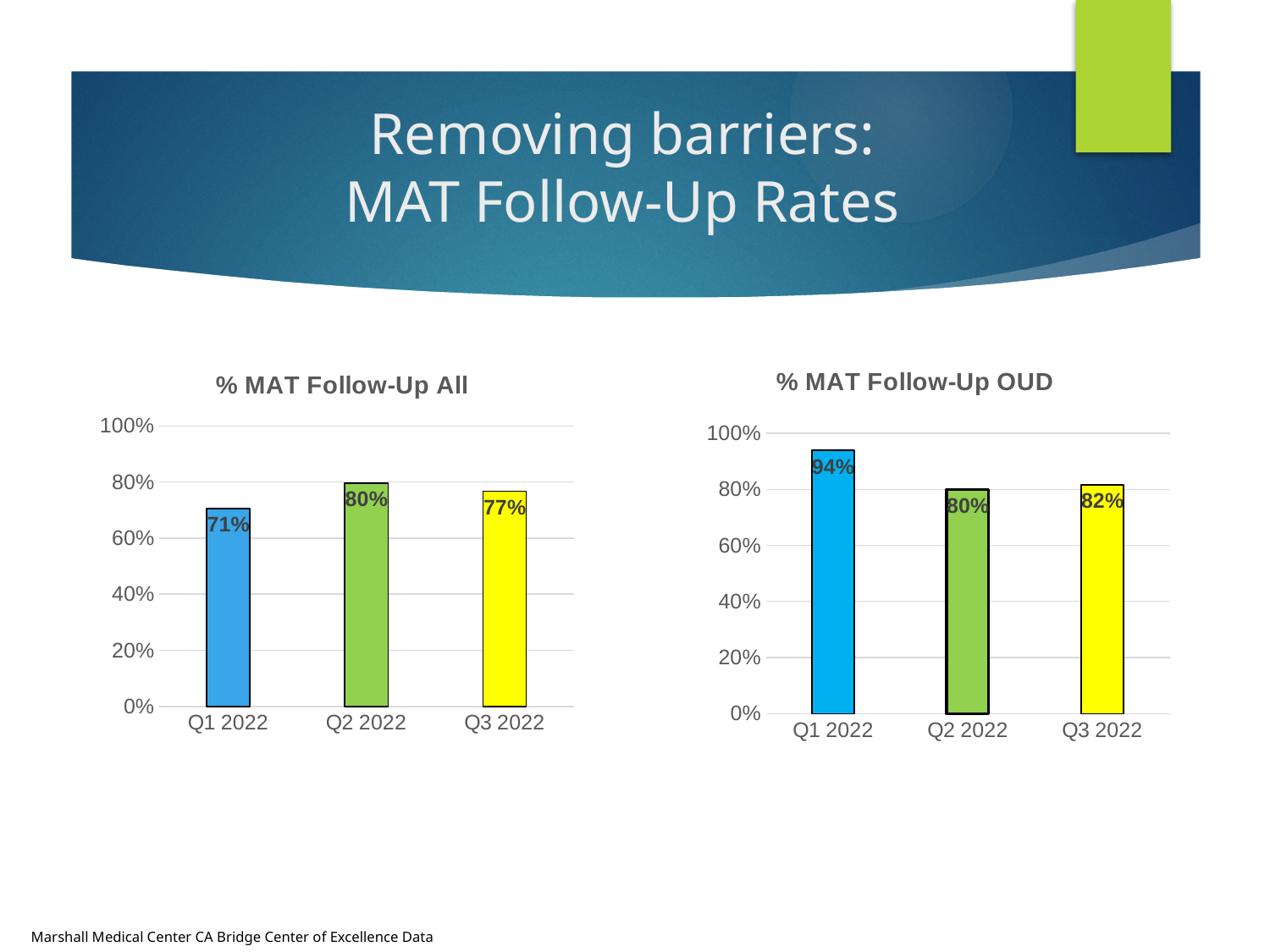
Which is larger: the Q1 2022 value in the '% MAT Follow-Up All' chart or the Q1 2022 value in the '% MAT Follow-Up OUD' chart? % MAT Follow-Up OUD What type of chart is the '% MAT Follow-Up All' chart? Bar chart In the '% MAT Follow-Up OUD' chart, what is the value for Q2 2022? 80% In the '% MAT Follow-Up All' chart, which quarter has the lowest value? Q1 2022 In the '% MAT Follow-Up OUD' chart, which quarter has the lowest value? Q2 2022 In the '% MAT Follow-Up All' chart, which quarter has the highest value? Q2 2022 In the '% MAT Follow-Up OUD' chart, what is the difference between the Q1 2022 and Q3 2022 values? 12% How many quarters are shown in the '% MAT Follow-Up OUD' chart? 3 In the '% MAT Follow-Up All' chart, what is the value for Q1 2022? 71% In the '% MAT Follow-Up All' chart, what is the difference between the Q2 2022 and Q1 2022 values? 9% In the '% MAT Follow-Up All' chart, what is the value for Q3 2022? 77% In the '% MAT Follow-Up OUD' chart, what is the value for Q1 2022? 94%